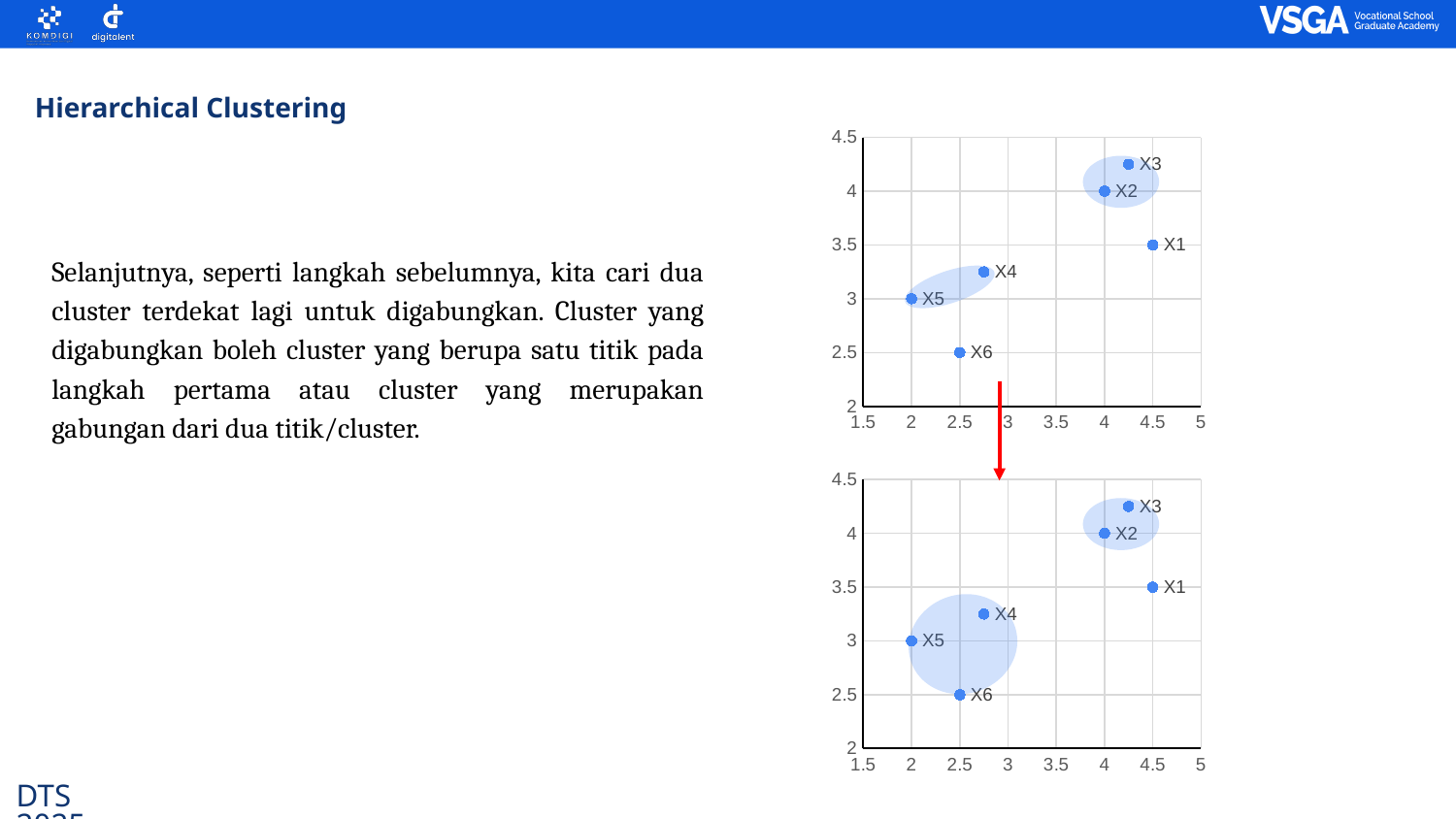
In the top chart, what is the x-axis value of point X1? 4.5 What kind of chart is the top chart on the slide? scatter chart How many labelled data points are plotted in the bottom chart? 6 In the bottom chart, how many points are enclosed by the large shaded ellipse on the left? 3 In the top chart, which point has the highest vertical (y) value? X3 In the bottom chart, what is the x-axis value of point X5? 2 In the top chart, what is the y-axis value of point X6? 2.5 In the top chart, which point has a larger y value, X2 or X1? X2 In the bottom chart, which point is farthest to the right (highest x value)? X1 In the top chart, which point has the lowest vertical (y) value? X6 In the bottom chart, which point is farthest to the left (lowest x value)? X5 In the bottom chart, is the y-axis value of point X4 greater or less than 3? greater